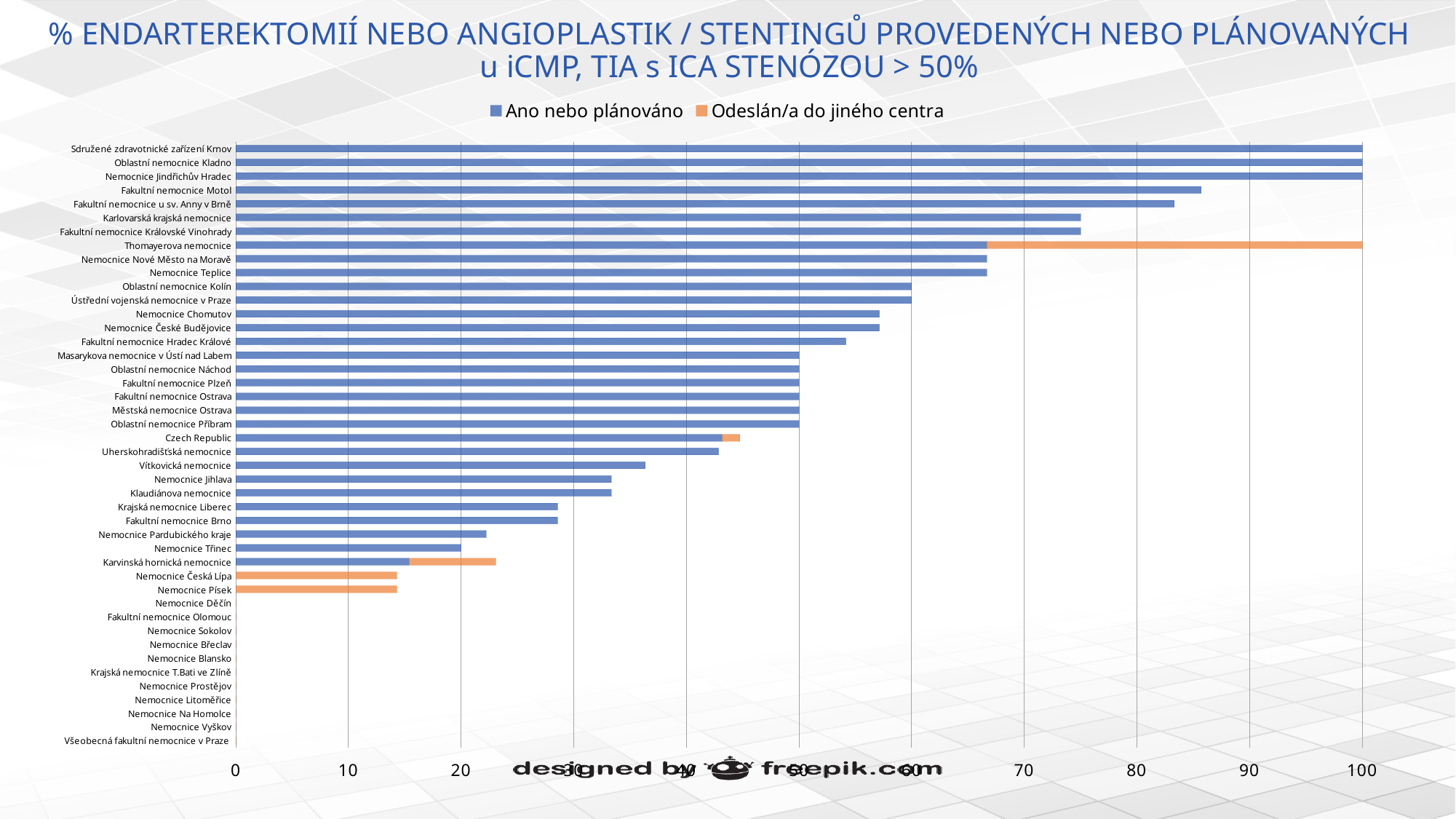
What is the value for Nemocnice Třinec? 20 Which series is shown in orange? Odeslán/a do jiného centra Which is larger, the value for Vítkovická nemocnice or the value for Nemocnice Jihlava? Vítkovická nemocnice What are the two series named in the legend? Ano nebo plánováno; Odeslán/a do jiného centra What is the total of the stacked bar for Thomayerova nemocnice? 100 Is the value for Fakultní nemocnice Motol greater or less than 80? greater What kind of chart is shown on the slide? bar chart What is the value for Sdružené zdravotnické zařízení Krnov? 100 What is the value for Oblastní nemocnice Kolín? 60 What is the value for Fakultní nemocnice Plzeň? 50 Is the value for Krajská nemocnice Liberec greater or less than 30? less How many series does the legend list? 2